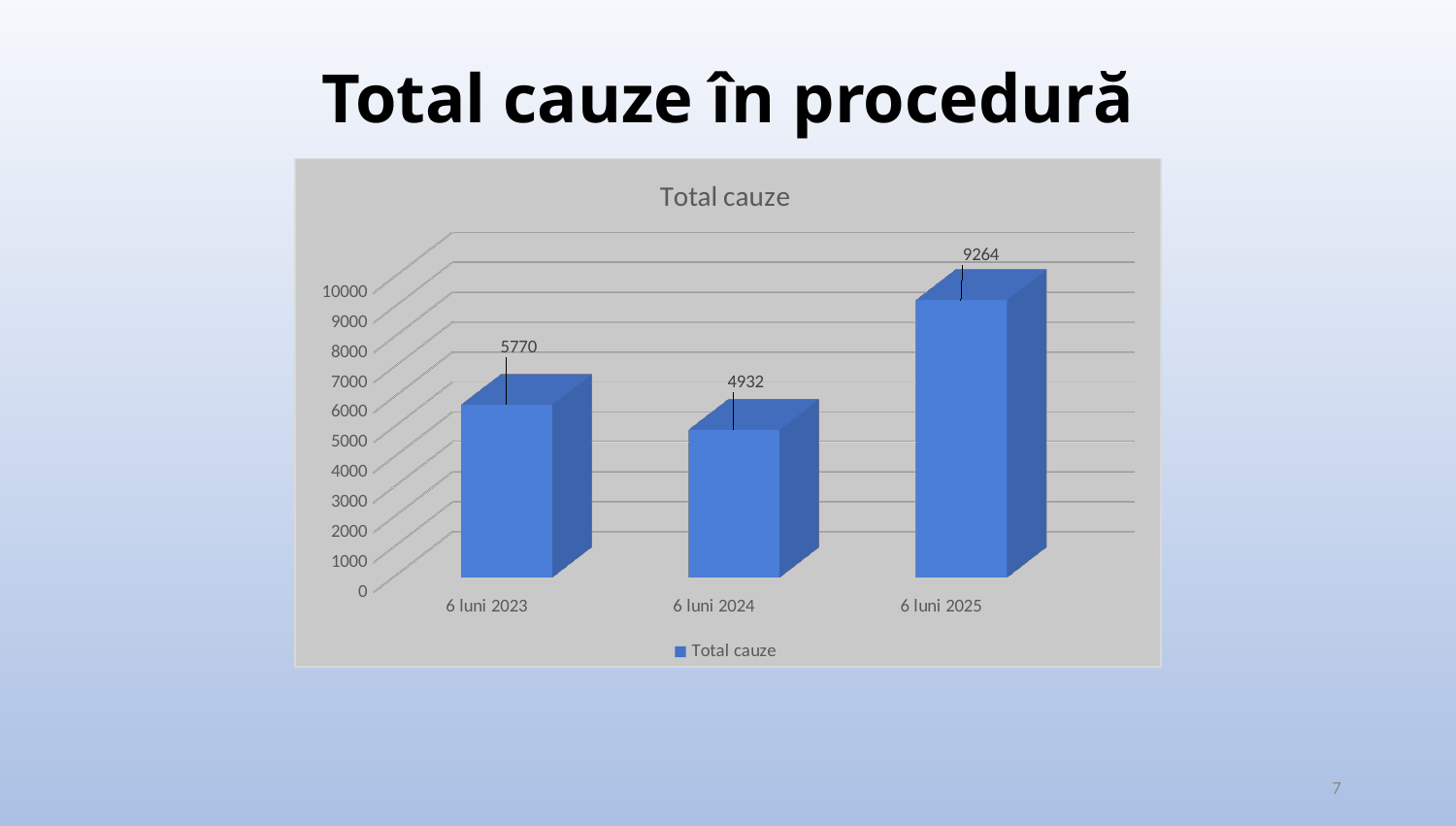
What kind of chart is shown on the slide? bar chart What is the title of the chart? Total cauze What is the value for 6 luni 2025? 9264 What is the difference between the values for 6 luni 2023 and 6 luni 2024? 838 What is the value for 6 luni 2024? 4932 Which category has the lowest value? 6 luni 2024 What is the value for 6 luni 2023? 5770 What is the difference between the values for 6 luni 2025 and 6 luni 2024? 4332 Which category has the highest value? 6 luni 2025 How many series does the legend list? 1 Which is larger, the value for 6 luni 2023 or the value for 6 luni 2024? 6 luni 2023 How many categories are shown on the x axis? 3